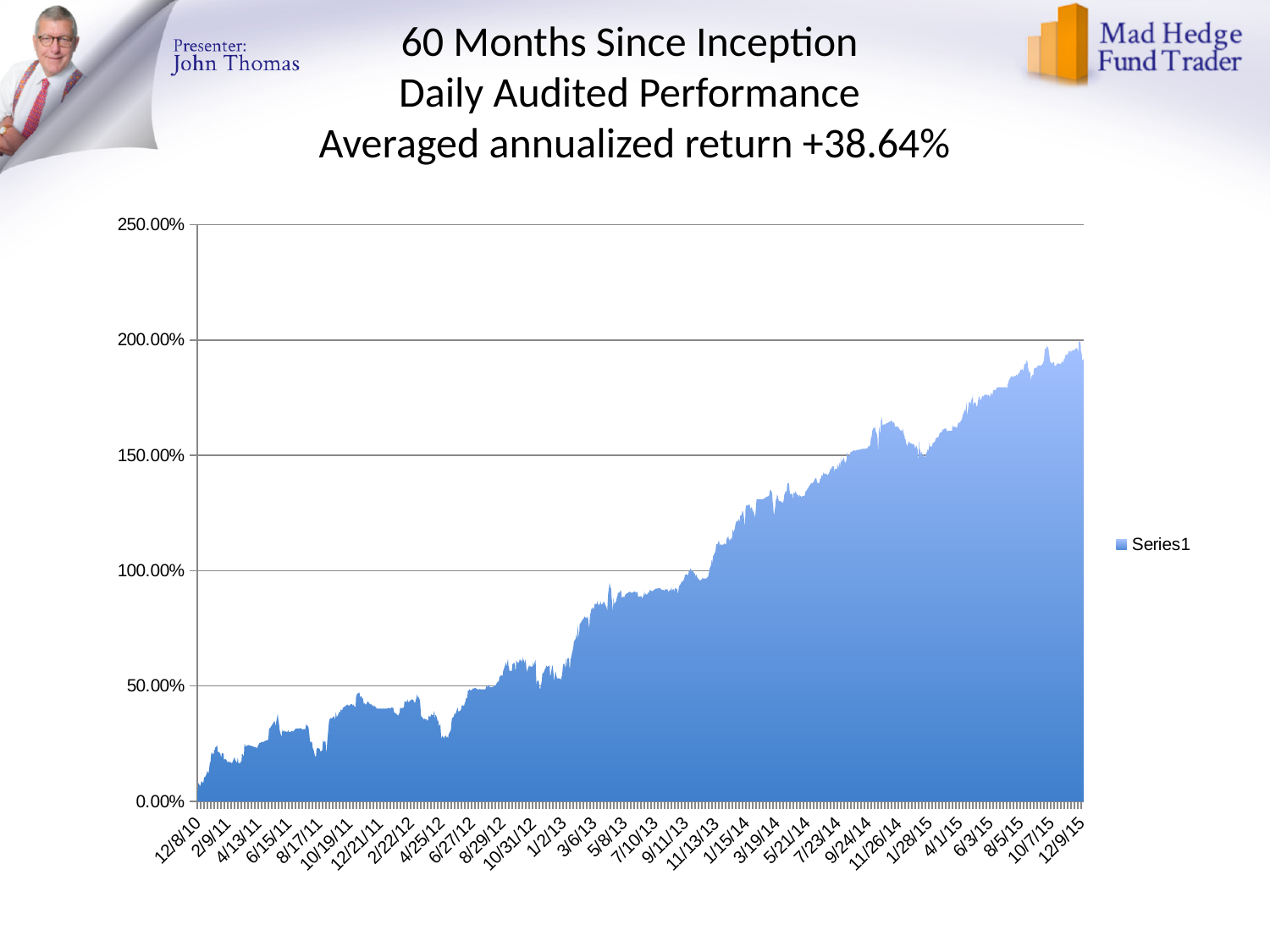
Is the value at 12/9/15 greater or less than 150.00%? greater Is the value at 12/8/10 greater or less than 50.00%? less What is the name of the series shown in the legend? Series1 Is the value at 4/25/12 greater or less than 50.00%? less What is the highest value shown on the y axis? 250.00% Overall, do the values rise or fall from 12/8/10 to 12/9/15? Rise What kind of chart is shown on the slide? Area chart What averaged annualized return is stated in the chart title? +38.64% How many series does the legend list? 1